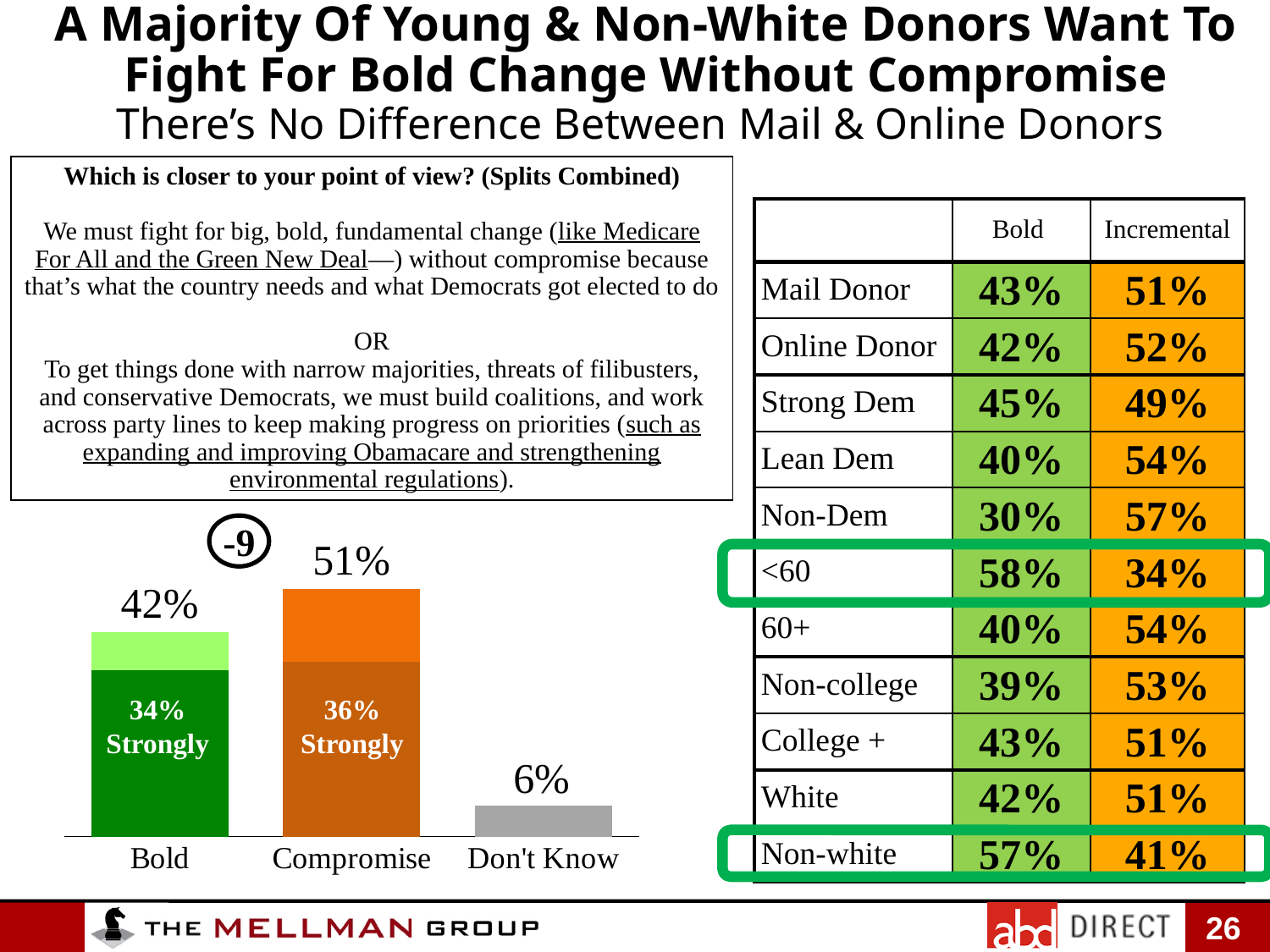
What kind of chart is shown on the slide? bar chart What is the total value shown for the Compromise bar? 51% Which is larger, the Bold total or the Compromise total? Compromise What number is shown in the circle above the Bold bar? -9 Which category has the lowest value on the bar chart? Don't Know What is the total value shown for the Bold bar? 42% What is the difference between the Compromise total and the Bold total? 9 percentage points What share of respondents are labelled as 'Strongly' within the Compromise bar? 36% How many categories are shown on the bar chart? 3 What share of respondents are labelled as 'Strongly' within the Bold bar? 34% What is the value shown for the Don't Know bar? 6% Which category has the highest value on the bar chart? Compromise